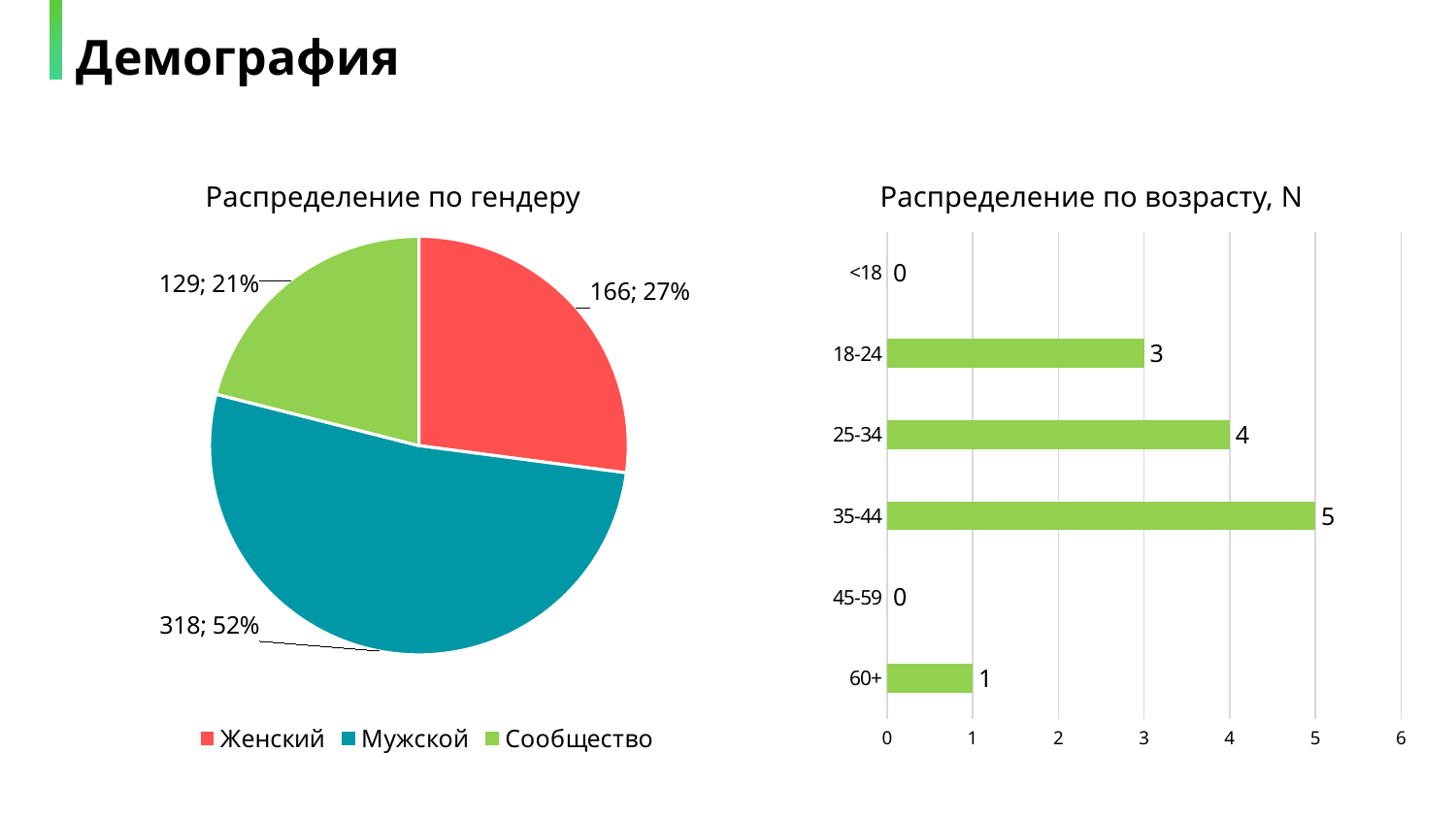
In the 'Распределение по возрасту, N' chart, which is larger: the value for 18-24 or the value for 60+? 18-24 How many entries does the legend of the 'Распределение по гендеру' chart list? 3 In the 'Распределение по гендеру' pie chart, what value is shown for Мужской? 318; 52% What type of chart is 'Распределение по возрасту, N'? Bar chart In the 'Распределение по гендеру' pie chart, what is the difference between the counts for Женский and Сообщество? 37 In the 'Распределение по возрасту, N' chart, which age group has the highest value? 35-44 In the 'Распределение по гендеру' pie chart, which category has the largest slice? Мужской In the 'Распределение по гендеру' pie chart, which category has the smallest slice? Сообщество In the 'Распределение по гендеру' pie chart, what share of the pie does Сообщество have? 21% In the 'Распределение по возрасту, N' chart, how many age categories are shown? 6 In the 'Распределение по возрасту, N' chart, what is the value for 25-34? 4 In the 'Распределение по возрасту, N' chart, what is the difference between the values for 35-44 and 18-24? 2